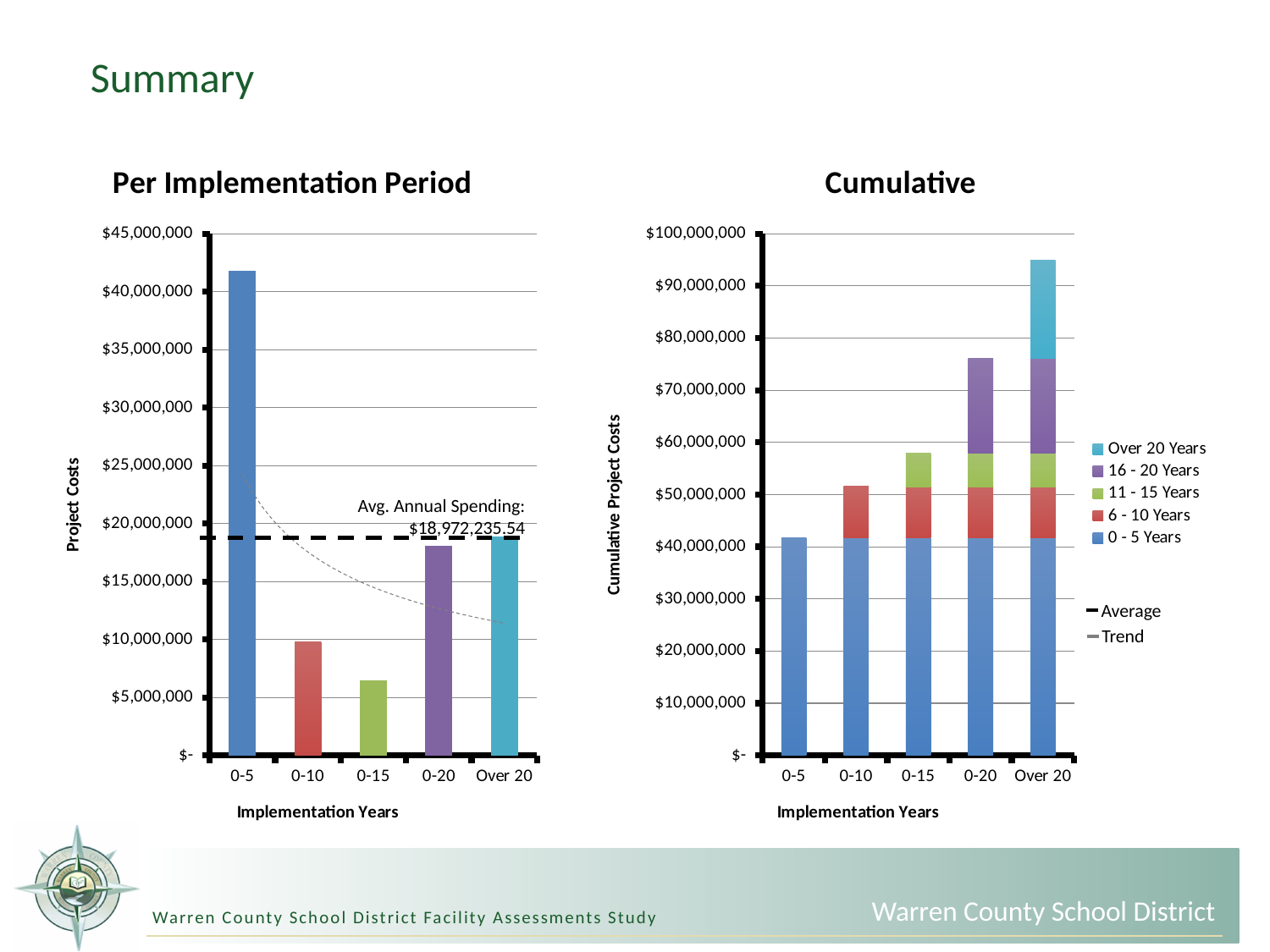
In the 'Cumulative' chart, is the total for Over 20 greater or less than $90,000,000? greater In the 'Per Implementation Period' chart, which implementation period has the lowest project cost? 0-15 In the 'Per Implementation Period' chart, is the value for 0-5 greater or less than $40,000,000? greater What average annual spending value is printed on the 'Per Implementation Period' chart? $18,972,235.54 In the 'Per Implementation Period' chart, which is larger, the value for 0-20 or the value for 0-10? 0-20 In the 'Per Implementation Period' chart, which implementation period has the highest project cost? 0-5 How many entries does the legend of the 'Cumulative' chart list? 7 In the 'Cumulative' chart, do the total bar heights rise or fall from 0-5 to Over 20? rise How many categories are shown on the x axis of the 'Per Implementation Period' chart? 5 What kind of chart is the 'Per Implementation Period' chart? bar chart In the 'Cumulative' chart, which implementation period has the highest total cumulative project cost? Over 20